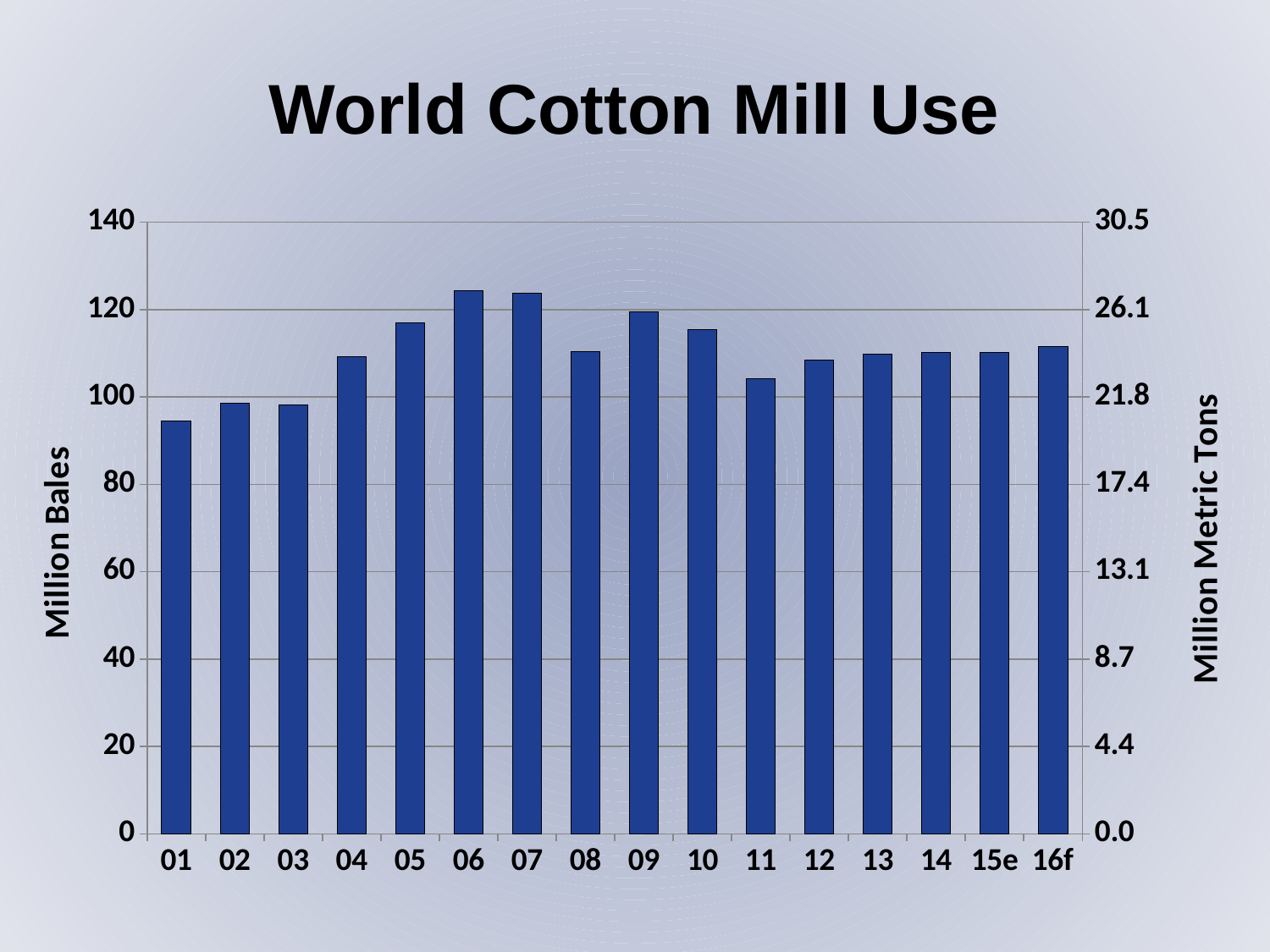
Do the values generally rise or fall from 01 to 06? rise Is the value for 16f greater or less than 120 million bales? less Which is larger, the value for 11 or the value for 12? 12 Is the value for 11 greater or less than 100 million bales? greater What kind of chart is shown on the slide? bar chart Is the value for 01 greater or less than 100 million bales? less How many years (bars) are shown on the x axis? 16 Which year has the lowest cotton mill use? 01 Which is larger, the value for 04 or the value for 05? 05 What is the title of the chart? World Cotton Mill Use What is the label of the left vertical axis? Million Bales